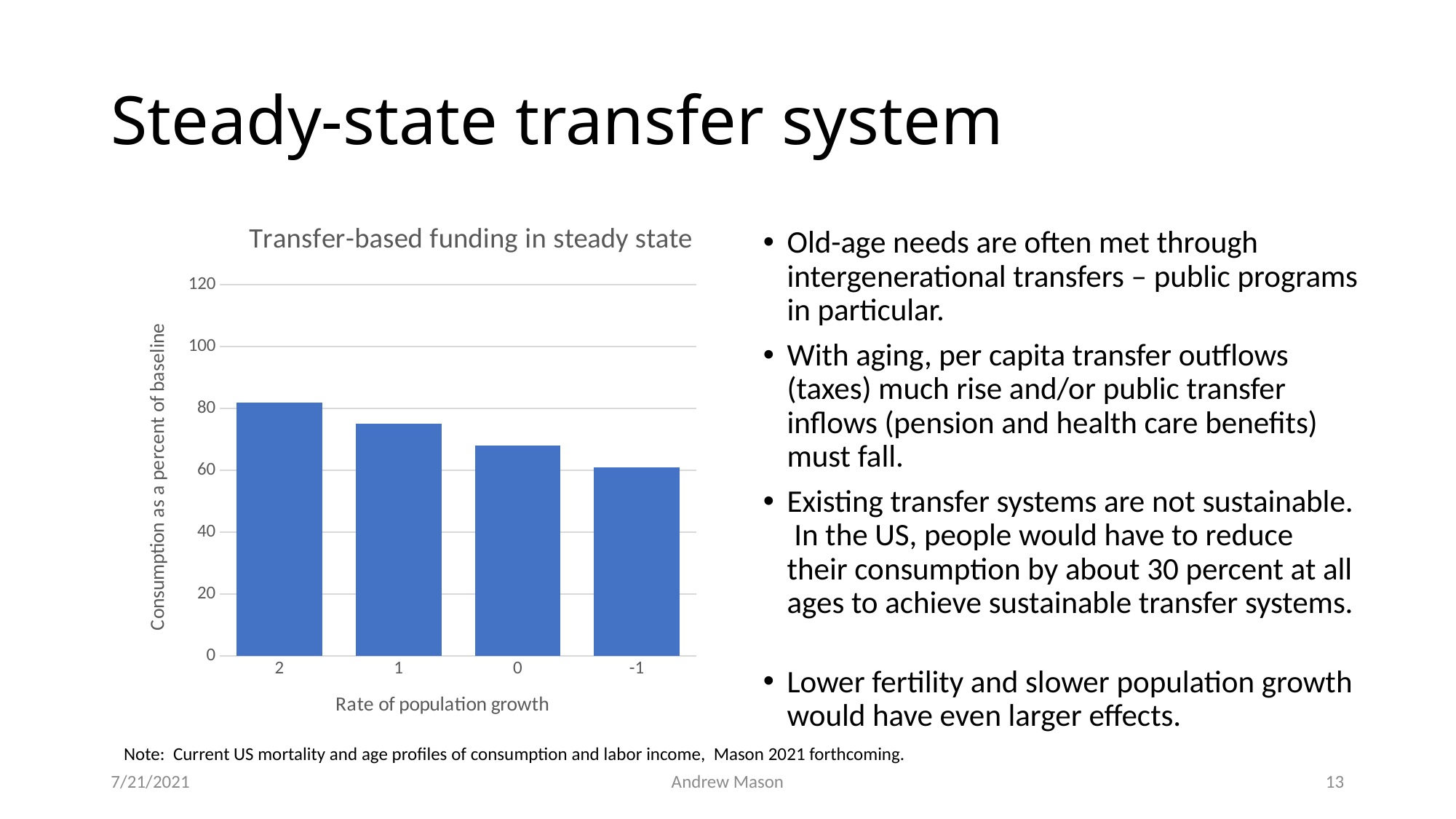
Do the bar values rise or fall moving from left to right along the x axis? fall Is the value for a population growth rate of 1 greater or less than 80? less What is the label of the x axis? Rate of population growth Is the value for a population growth rate of 2 greater or less than 80? greater Which rate of population growth has the highest consumption as a percent of baseline? 2 Is the value for a population growth rate of -1 greater or less than 80? less What is the title of the chart? Transfer-based funding in steady state Which has a larger value: a population growth rate of 1 or a population growth rate of -1? 1 How many bars are plotted in the chart? 4 Which rate of population growth has the lowest consumption as a percent of baseline? -1 What type of chart is shown on the slide? bar chart